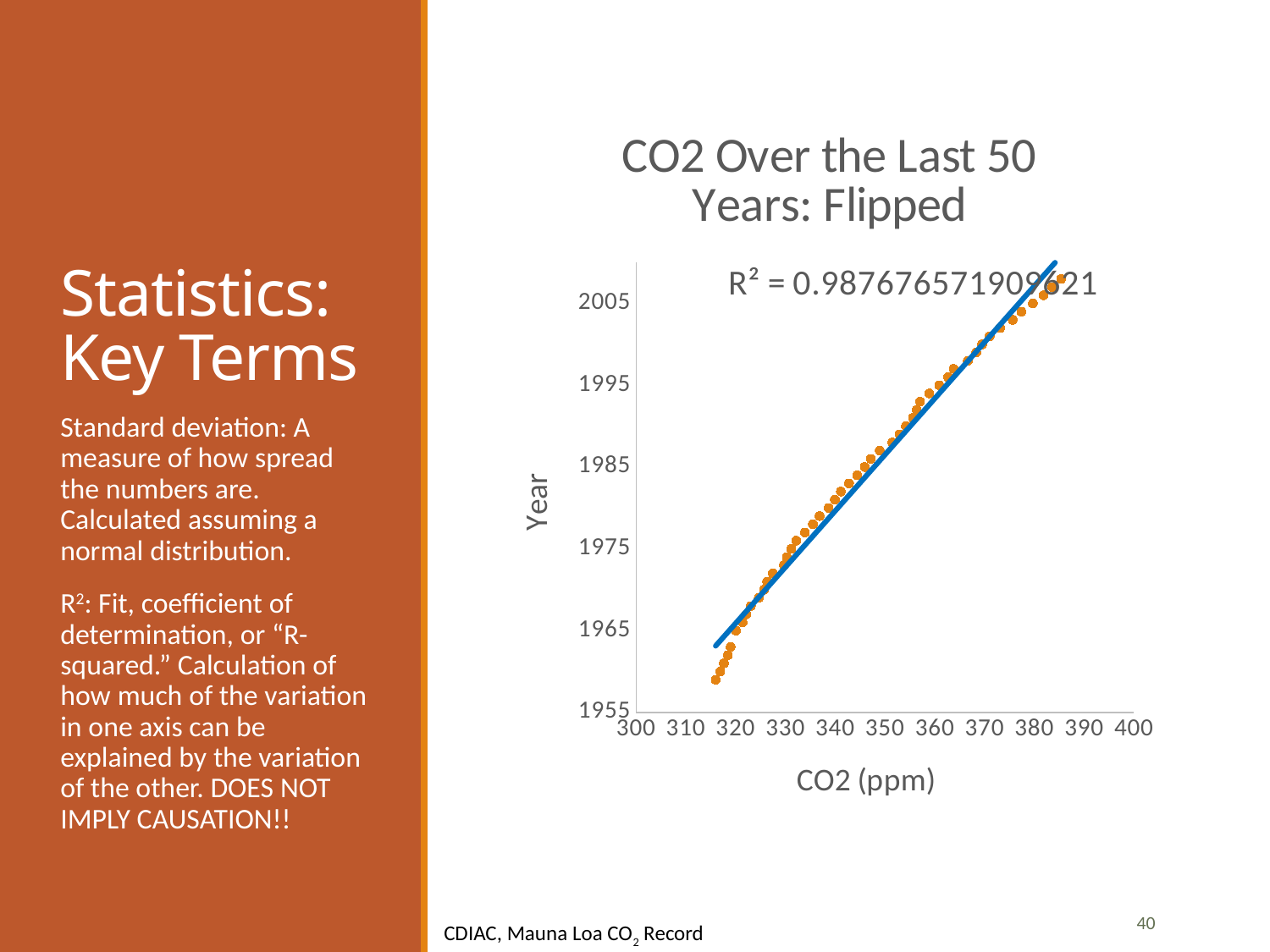
Which has the higher CO2 value: the point at Year 1965 or the point at Year 2005? The point at Year 2005 What kind of chart is shown on the slide? Scatter chart For the points at about 320 ppm CO2, is the Year greater or less than 1975? less As CO2 (ppm) increases along the x axis, does the Year rise or fall? Rise For the points at about 380 ppm CO2, is the Year greater or less than 1995? greater For the point at Year 1985, is the CO2 value greater or less than 330 ppm? greater What is the title of the chart? CO2 Over the Last 50 Years: Flipped Is the R² value shown on the chart greater or less than 0.9? greater